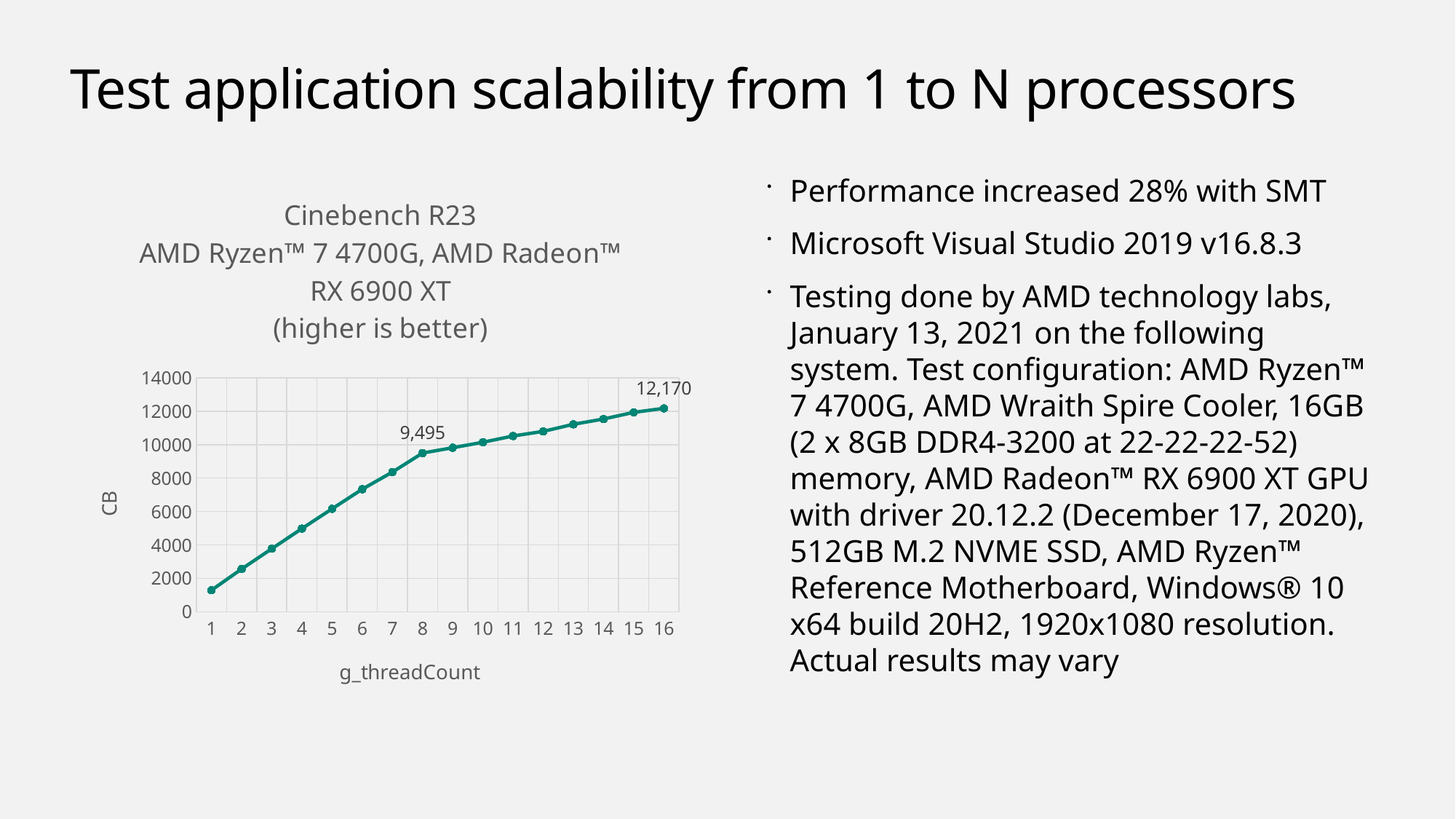
At which g_threadCount is the CB value lowest? 1 What is the CB value at g_threadCount 8? 9,495 Do the CB values rise or fall as g_threadCount increases from 1 to 16? Rise What is the CB value at g_threadCount 16? 12,170 What is the difference between the CB values at g_threadCount 16 and g_threadCount 8? 2,675 What is the label on the vertical axis of the chart? CB Is the CB value at g_threadCount 12 greater or less than 10000? greater Is the CB value at g_threadCount 4 greater or less than 6000? less At which g_threadCount is the CB value highest? 16 What kind of chart is shown on the slide? Line chart Which has a larger CB value, g_threadCount 4 or g_threadCount 8? g_threadCount 8 How many data points are plotted on the chart? 16